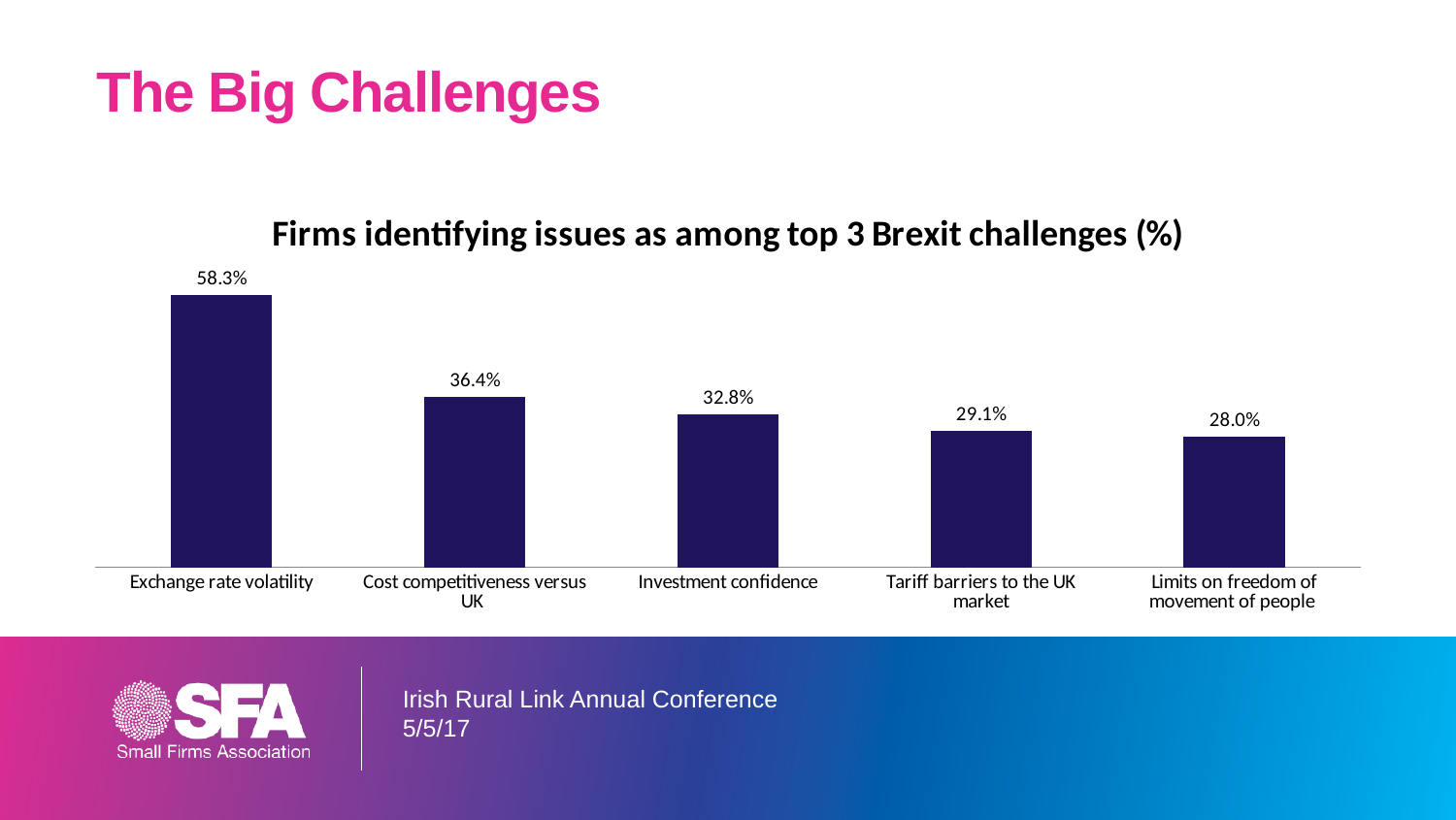
What is the value for Investment confidence? 32.8% Do the values rise or fall from left to right across the chart? Fall Which is larger: the value for Cost competitiveness versus UK or the value for Investment confidence? Cost competitiveness versus UK What is the difference between the values for Tariff barriers to the UK market and Limits on freedom of movement of people? 1.1% What kind of chart is shown on the slide? Bar chart What percentage of firms identified exchange rate volatility as a top 3 Brexit challenge? 58.3% What is the value for Limits on freedom of movement of people? 28.0% How many challenges are shown in the chart? 5 What is the title of the chart? Firms identifying issues as among top 3 Brexit challenges (%) What is the difference between the values for Exchange rate volatility and Cost competitiveness versus UK? 21.9% Which challenge has the lowest percentage of firms identifying it? Limits on freedom of movement of people Which challenge has the highest percentage of firms identifying it? Exchange rate volatility